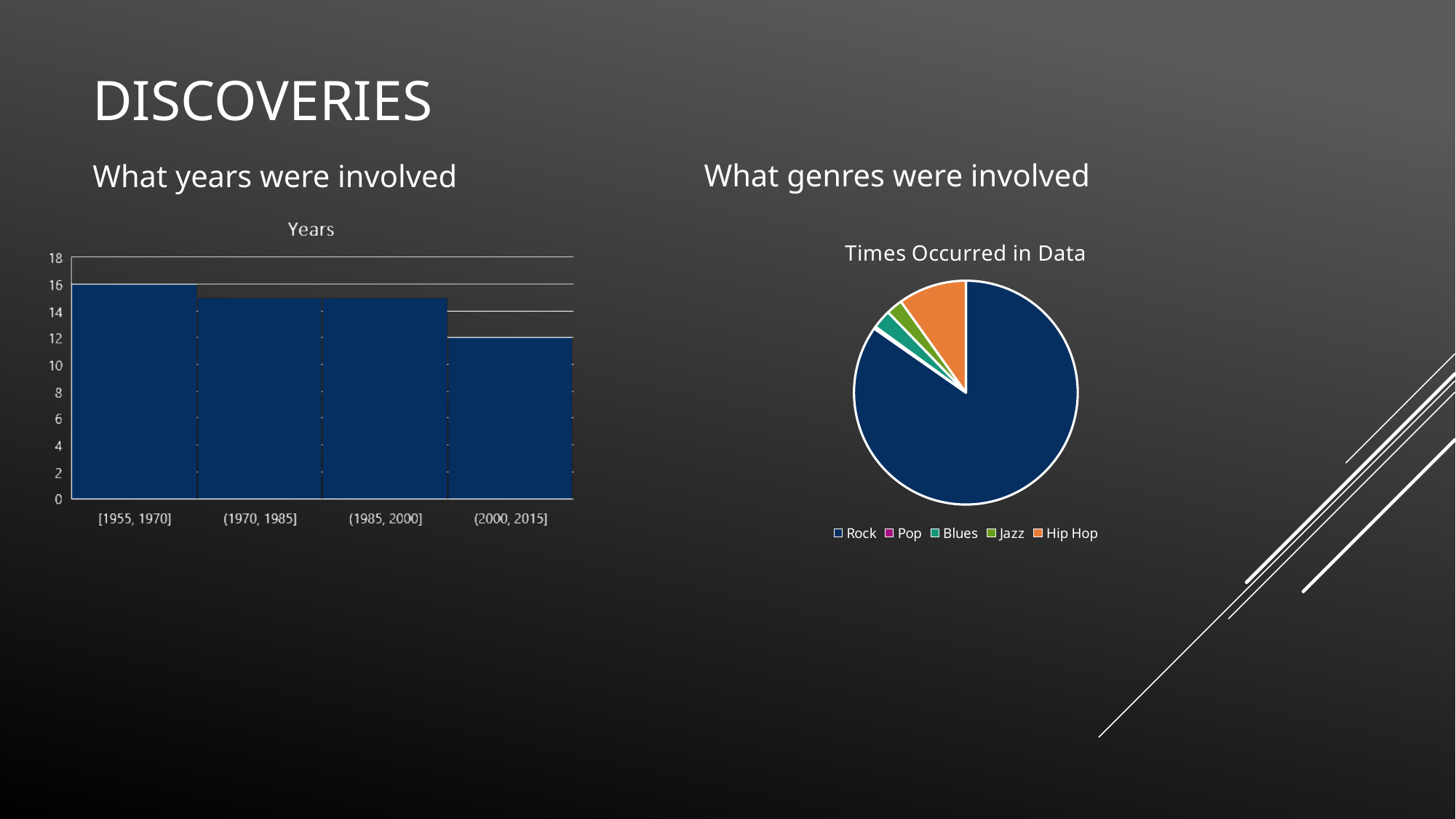
In the 'Years' chart, what is the value for the (2000, 2015] bin? 12 In the 'Years' chart, which year bin has the highest value? [1955, 1970] In the 'Times Occurred in Data' chart, which genre has the largest slice? Rock What kind of chart is the 'Times Occurred in Data' chart on the right of the slide? pie chart What kind of chart is the 'Years' chart on the left of the slide? bar chart How many year bins are shown in the 'Years' chart? 4 In the 'Years' chart, what is the difference between the [1955, 1970] bin and the (2000, 2015] bin? 4 In the 'Years' chart, what is the value for the [1955, 1970] bin? 16 In the 'Years' chart, is the value for the (1970, 1985] bin greater or less than 14? greater In the 'Years' chart, which year bin has the lowest value? (2000, 2015] How many genres does the legend of the 'Times Occurred in Data' chart list? 5 In the 'Years' chart, do the values rise or fall from the earliest bin to the latest bin? fall